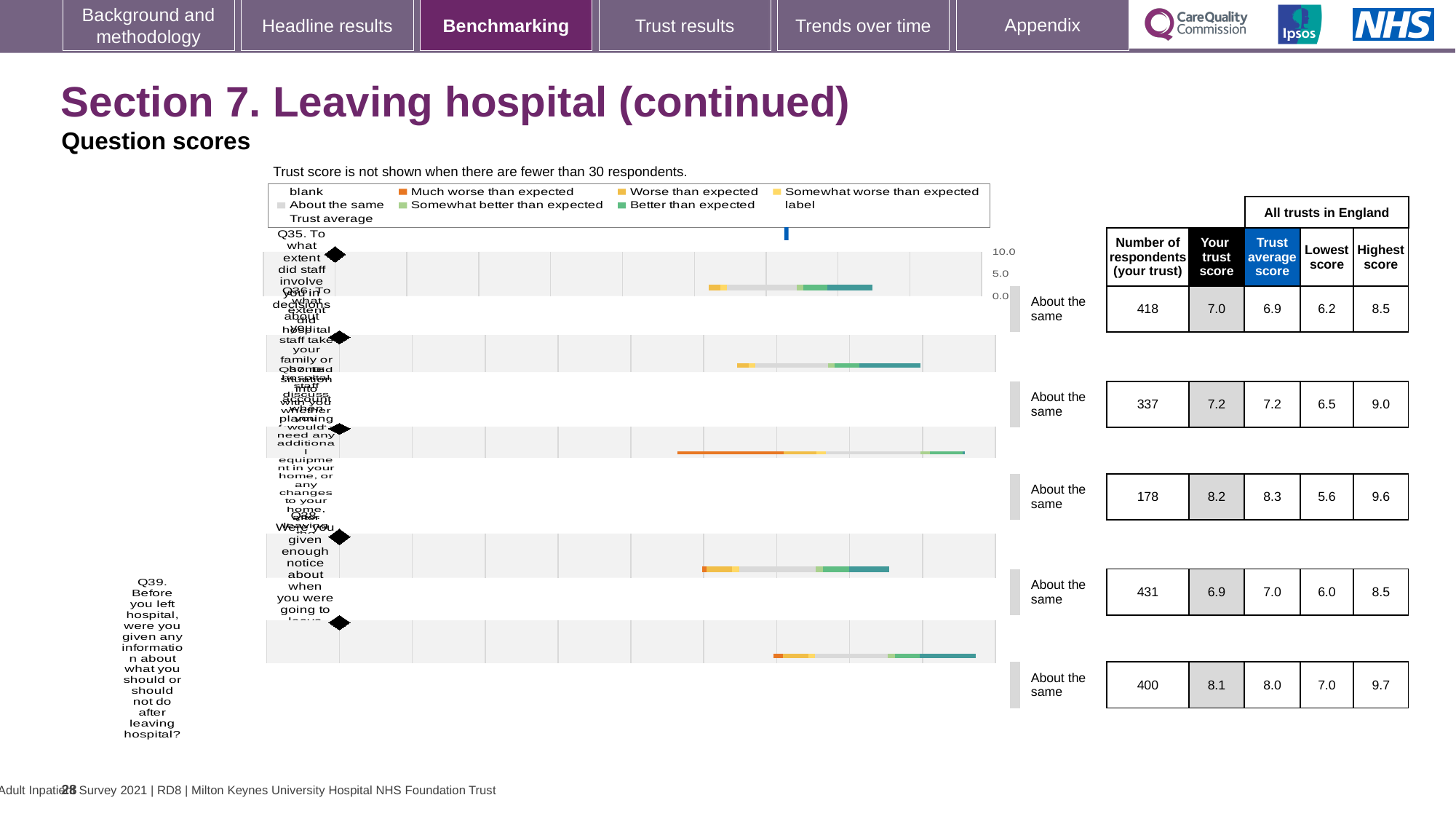
Which question has the highest 'Your trust score'? Q37 Is the trust score for Q37 greater or less than 5.0? greater Which question has the fewest respondents? Q37 What benchmark category is shown for every question on this slide? About the same How many questions (Q35 to Q39) are plotted in the chart? 5 What is the highest score across all trusts in England for Q39? 9.7 What is the number of respondents for Q37? 178 Which question has the lowest 'Your trust score'? Q38 For Q35, which is larger: the trust score or the trust average score? Trust score (7.0) What is the difference between the highest score (9.7) and the lowest score (7.0) for Q39? 2.7 What is the trust score for Q35 (staff involving you in decisions about leaving hospital)? 7.0 What kind of chart is used to show the question scores on this slide? Bar chart